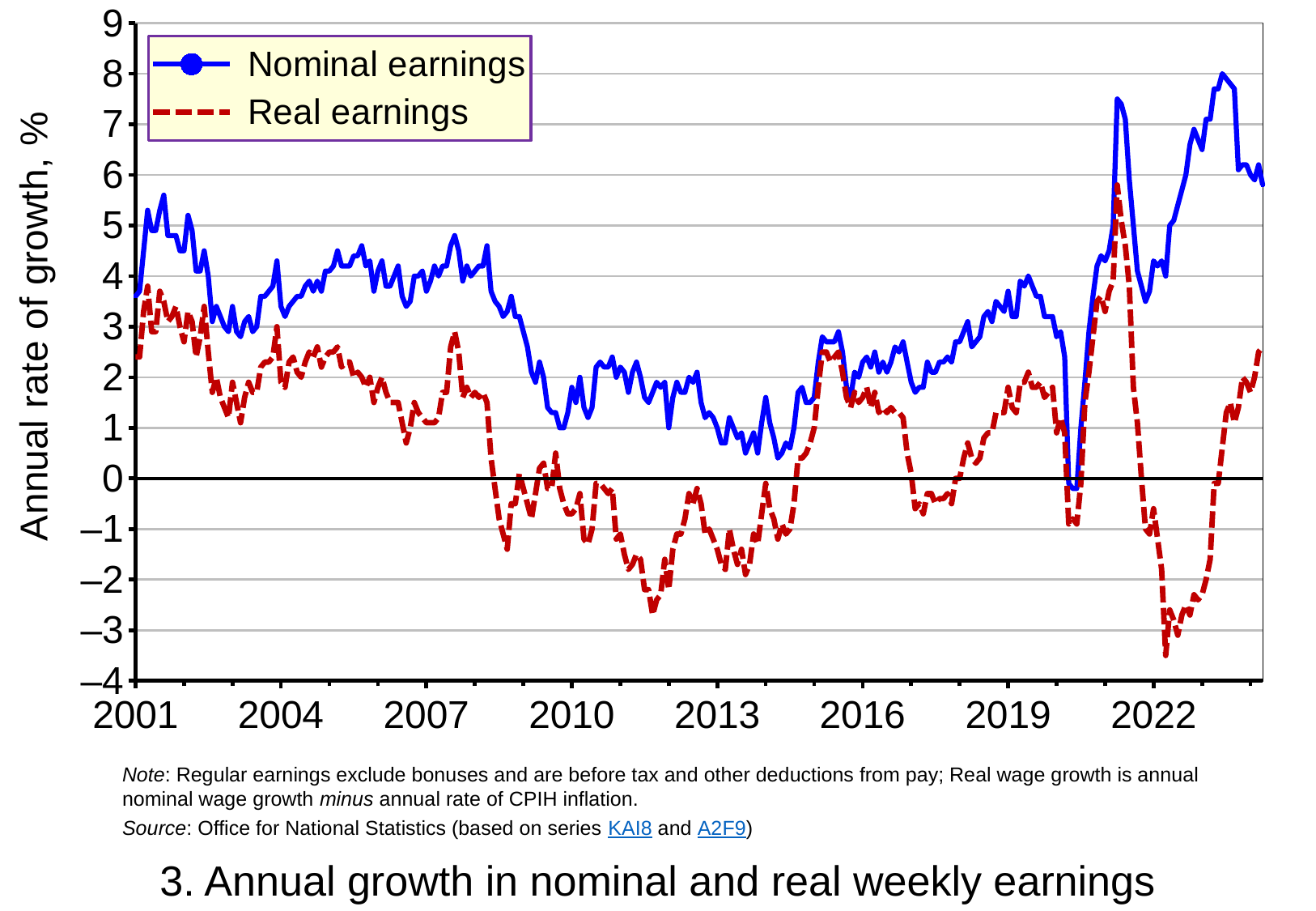
In 2022, which series has the higher value, Nominal earnings or Real earnings? Nominal earnings How many series does the legend list? 2 Which series is drawn with a red dashed line? Real earnings Which series reaches the highest value anywhere on the chart? Nominal earnings Is the lowest value of Real earnings around 2011-2012 greater or less than -2? less Is the peak value of Nominal earnings around 2021 greater or less than 7? greater What kind of chart is shown on the slide? Line chart Does the Real earnings series rise or fall between its peak in 2021 and 2022? Fall Is the lowest value of Real earnings, reached around 2022, greater or less than -3? less Which series reaches the lowest value anywhere on the chart? Real earnings What is the title of the chart? 3. Annual growth in nominal and real weekly earnings